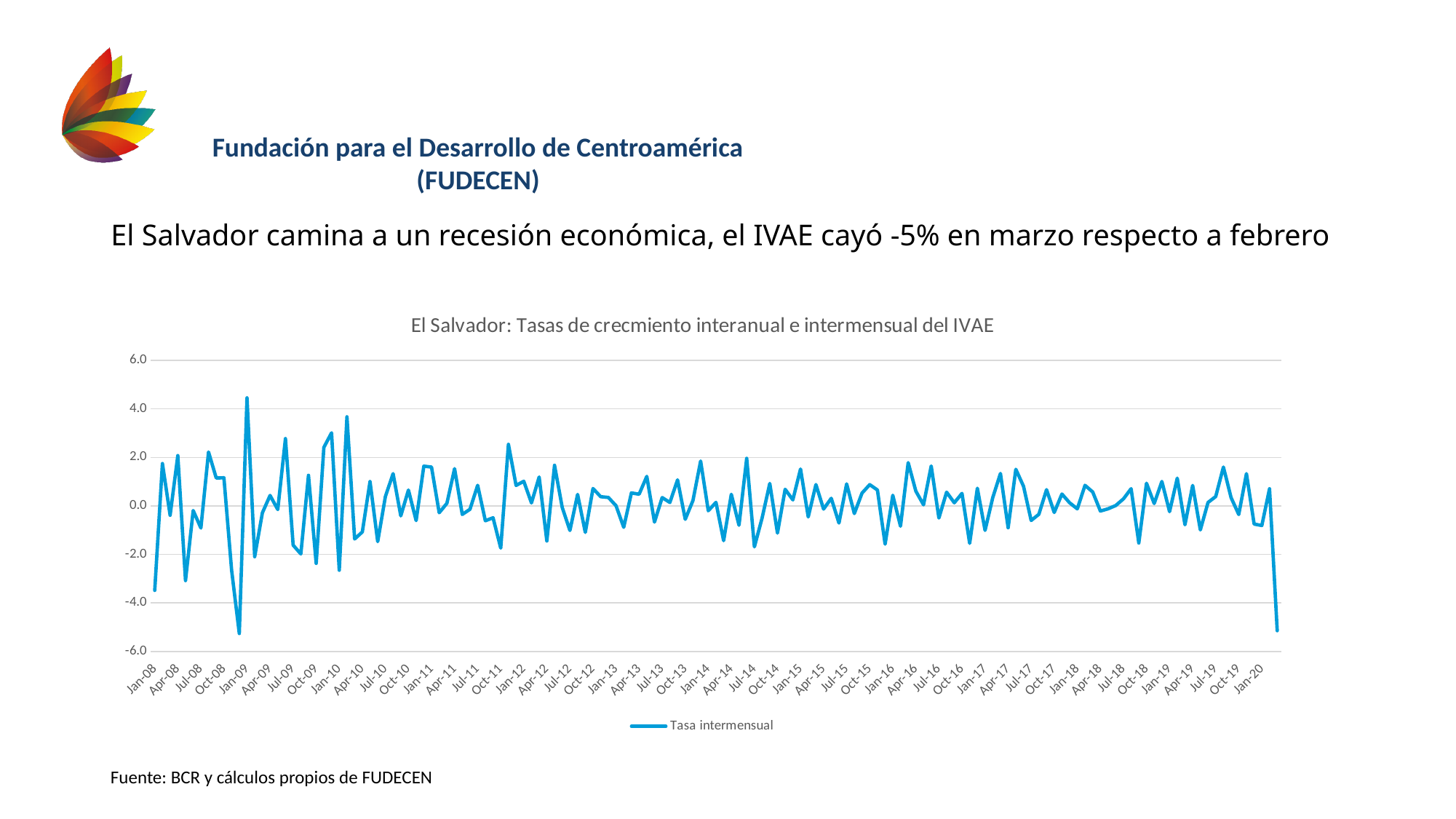
Which is larger: the peak of the series in early 2009 or the peak around Apr-10? the peak in early 2009 Is the sharp dip of the series around Jan-09 greater or less than -4.0? less Is the peak of the series around Apr-10 greater or less than 2.0? greater What is the title of the chart? El Salvador: Tasas de crecmiento interanual e intermensual del IVAE Is the value for the first point of the series (Jan-08) greater or less than -2.0? less What kind of chart is shown on the slide? line chart What is the name of the series shown in the legend? Tasa intermensual How many series does the legend list? 1